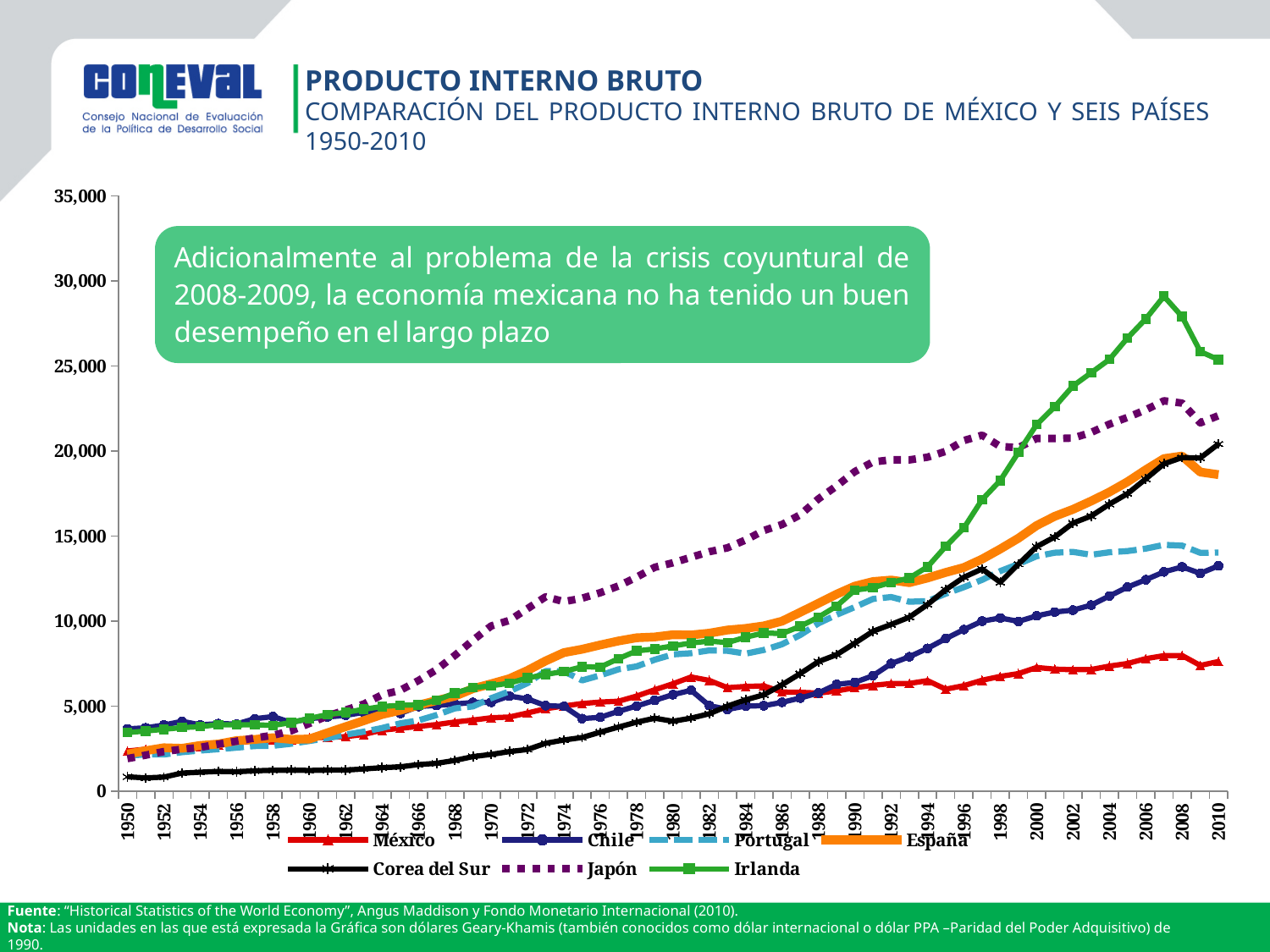
How many series does the legend list? 7 Which country has the highest value in 1980? Japón Which country is plotted with the red line? México Is the value for México in 2010 greater or less than 10,000? less Does the value for Corea del Sur rise or fall from 1950 to 2010? rise Is the value for Irlanda in 2007 greater or less than 25,000? greater Which country has the lowest value in 2010? México Is the value for Corea del Sur in 1950 greater or less than 5,000? less In 2000, which is larger, the value for Japón or the value for Chile? Japón What kind of chart is shown on the slide? line chart Which country has the lowest value in 1950? Corea del Sur Which country has the highest value in 2010? Irlanda